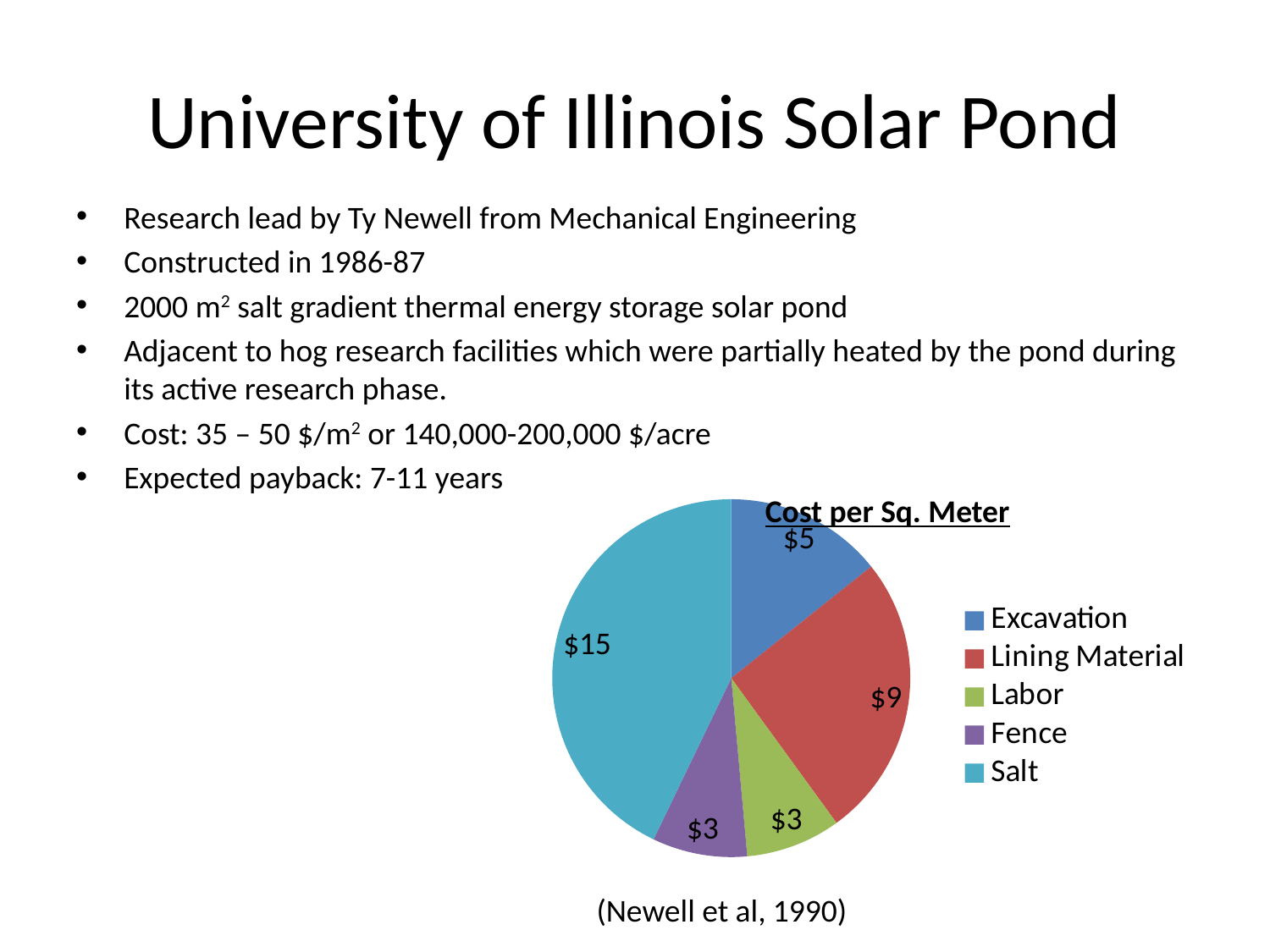
What type of chart is shown on the slide? pie chart Which is larger, the cost for Excavation or the cost for Labor? Excavation Which category has the largest slice of the pie? Salt How many categories does the legend list? 5 What is the cost per square meter for Lining Material? $9 What colour is the Salt slice in the pie chart? teal (light blue) What is the difference between the Salt cost and the Lining Material cost? $6 What is the cost per square meter for Fence? $3 What is the cost per square meter for Excavation? $5 What is the total cost per square meter across all slices of the pie? $35 What is the cost per square meter for Salt? $15 What is the title of the chart? Cost per Sq. Meter